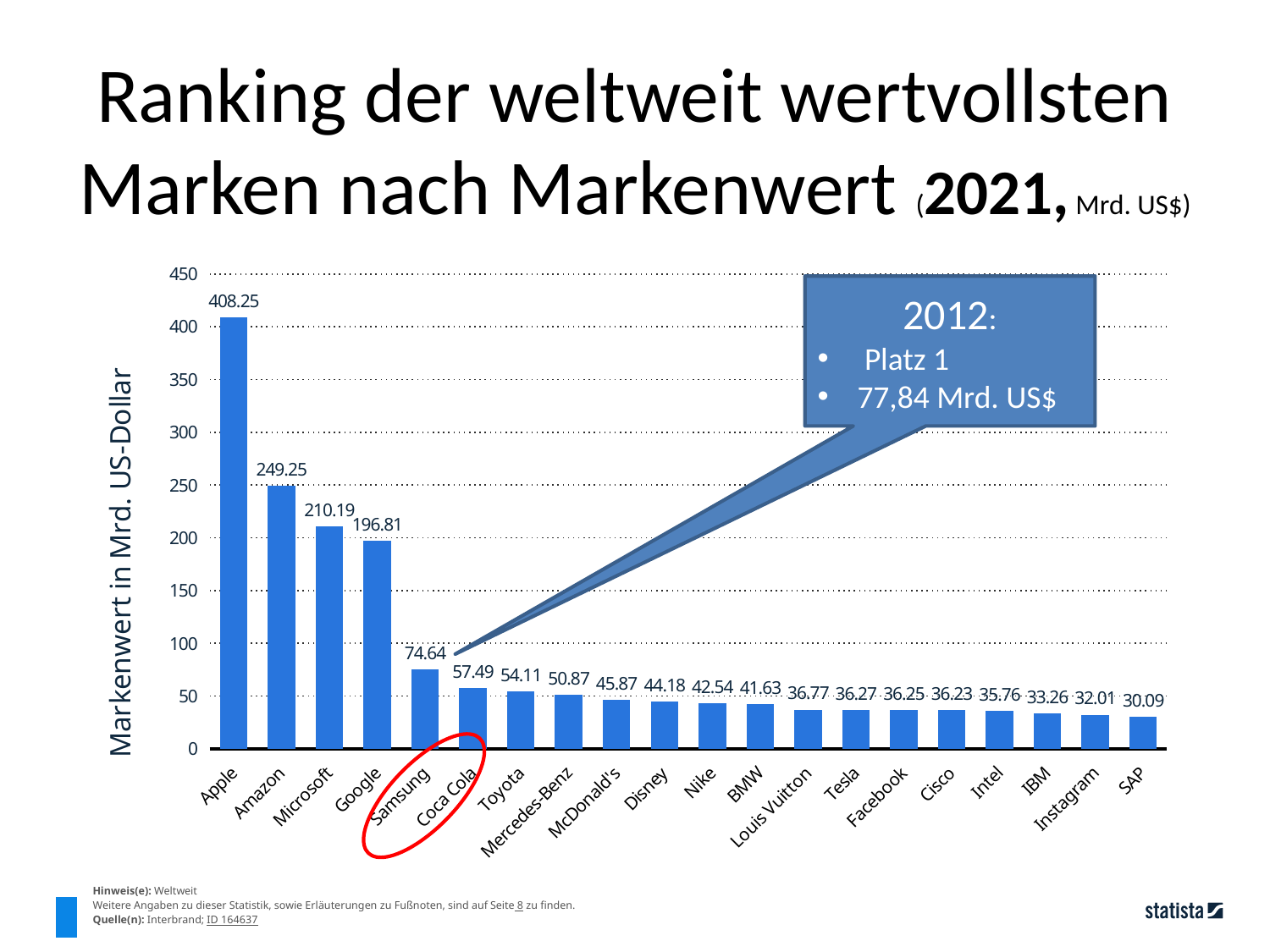
Which brand has the highest brand value in the chart? Apple What is the difference between the brand values of Apple and Amazon? 159.00 Do the brand values rise or fall from left to right along the x axis? fall What is the brand value shown for Apple? 408.25 Which has a larger brand value, Microsoft or Google? Microsoft What is the brand value shown for Tesla? 36.27 What is the brand value shown for Samsung? 74.64 How many brands are shown in the chart? 20 Is the value for Amazon greater or less than 200? greater What kind of chart is shown on the slide? bar chart What is the difference between the brand values of Samsung and Coca Cola? 17.15 Which brand has the lowest brand value in the chart? SAP